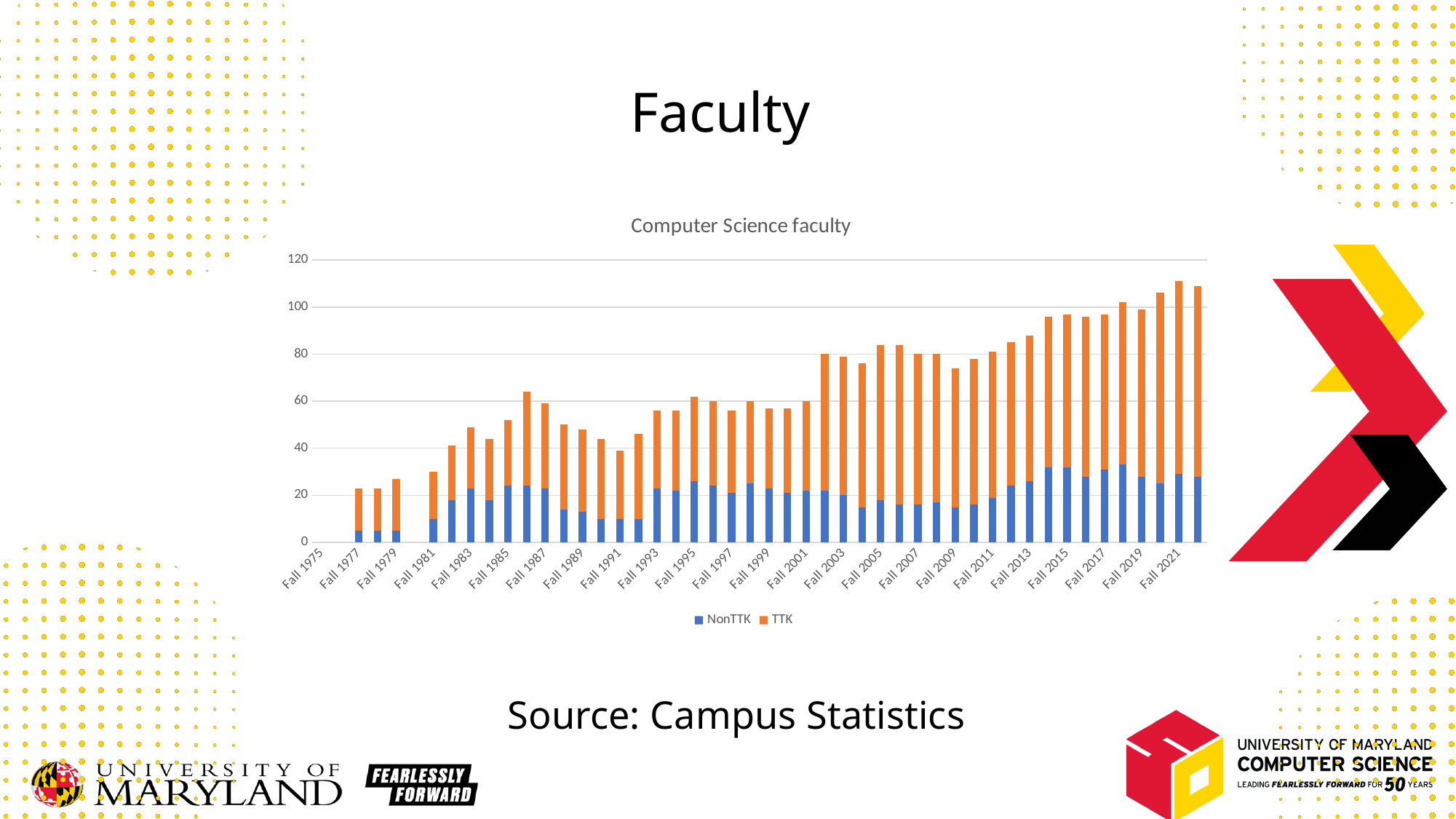
What are the two series named in the legend of the chart? NonTTK and TTK Is the total faculty value for Fall 1981 greater or less than 40? less What is the title of the chart on the slide? Computer Science faculty Is the total faculty value for Fall 2021 greater or less than 100? greater What kind of chart is shown on the slide? stacked bar chart Is the total faculty value for Fall 2013 greater or less than 80? greater Overall, do the total faculty values rise or fall from Fall 1977 to Fall 2022? rise Which has a larger total faculty value, Fall 1987 or Fall 1991? Fall 1987 Which has a larger total faculty value, Fall 2021 or Fall 2001? Fall 2021 How many series does the legend of the Computer Science faculty chart list? 2